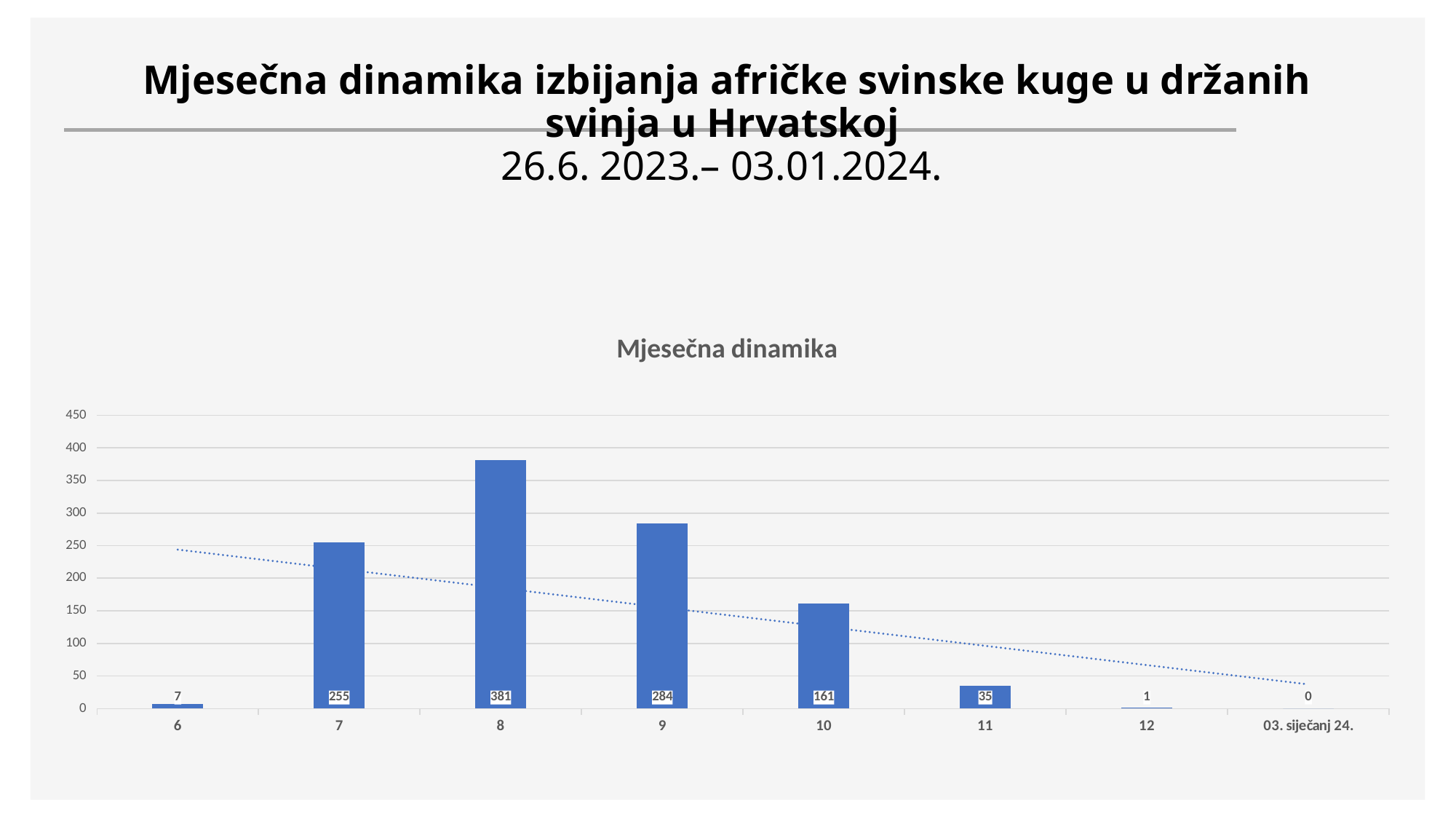
How many categories are shown on the x axis? 8 What is the value for category 12? 1 Which is larger, the value for category 7 or the value for category 9? 9 Which category has the lowest value? 03. siječanj 24. What is the difference between the values for categories 8 and 9? 97 What is the value for category 10? 161 Do the values rise or fall from category 8 to category 12? fall What is the title of the chart? Mjesečna dinamika Is the value for category 9 greater or less than 250? greater Which category has the highest value? 8 What is the value for category 8? 381 What kind of chart is shown? bar chart